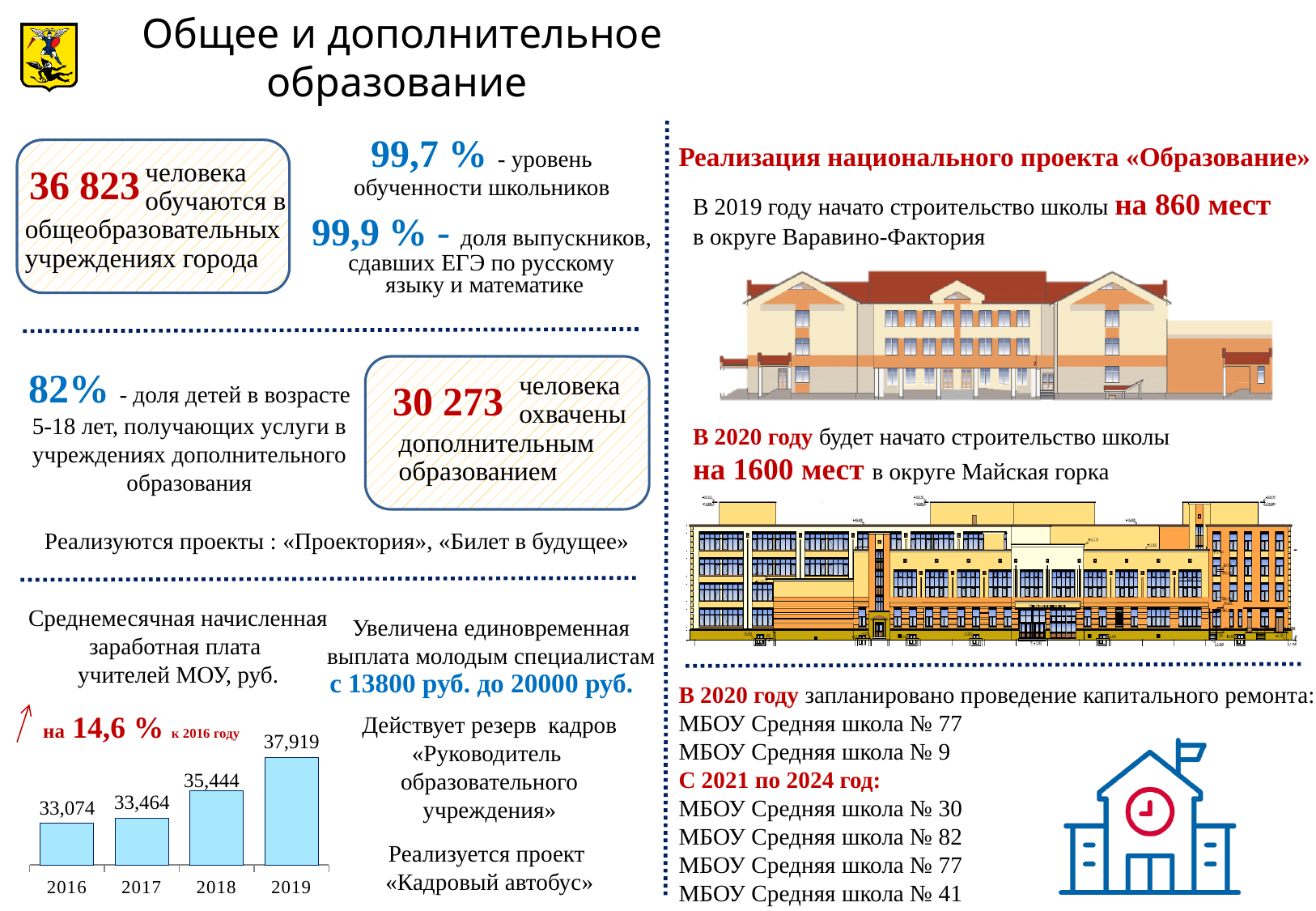
What is the average monthly teacher salary shown for 2018? 35,444 Do the teacher salary values rise or fall from 2016 to 2019? rise What is the average monthly teacher salary shown for 2019? 37,919 What is the average monthly teacher salary shown for 2016? 33,074 Which year has the highest average monthly teacher salary in the chart? 2019 How many years are shown in the teacher salary bar chart? 4 Which year has the lowest average monthly teacher salary in the chart? 2016 What is the average monthly teacher salary shown for 2017? 33,464 What is the difference between the teacher salary values for 2019 and 2016? 4,845 What is the difference between the teacher salary values for 2018 and 2017? 1,980 Which is larger in the teacher salary chart: the value for 2018 or the value for 2017? 2018 What type of chart shows the average monthly salary of teachers (Среднемесячная начисленная заработная плата учителей МОУ)? bar chart